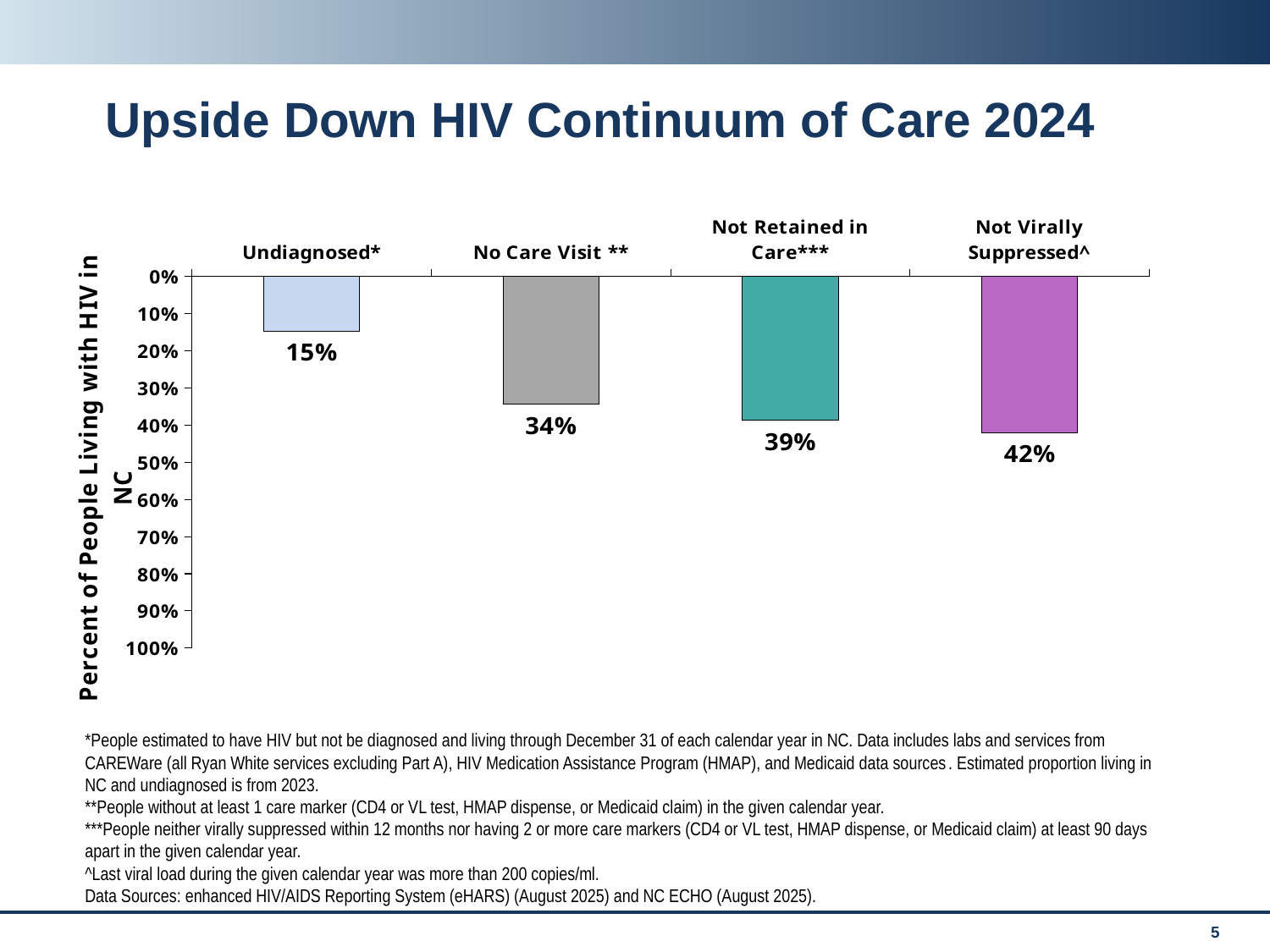
What is the value for Not Retained in Care***? 39% What is the difference between the values for Not Virally Suppressed^ and Undiagnosed*? 27% Which category has the highest value? Not Virally Suppressed^ Do the values rise or fall moving from left to right across the categories? Rise What is the value for Not Virally Suppressed^? 42% Which category has the lowest value? Undiagnosed* What is the value for No Care Visit **? 34% How many categories are shown in the chart? 4 Which is larger, the value for No Care Visit ** or the value for Not Retained in Care***? Not Retained in Care*** What is the label of the vertical axis? Percent of People Living with HIV in NC What is the value for Undiagnosed*? 15% What kind of chart is shown on the slide? Bar chart